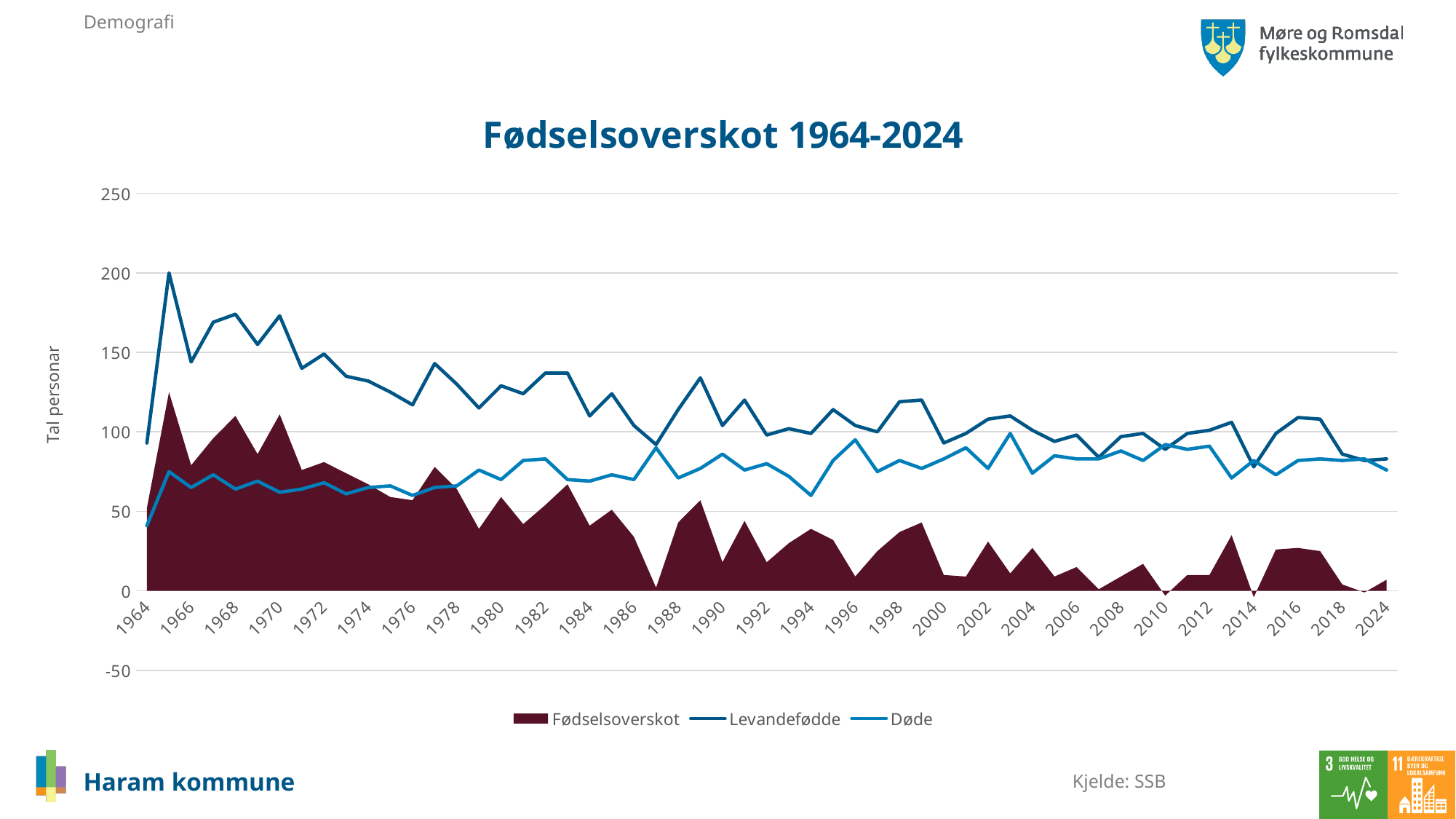
Which is larger in 1965, Levandefødde or Døde? Levandefødde Is the value for Døde in 1964 greater or less than 50? less What is the title of the chart? Fødselsoverskot 1964-2024 Is the value for Fødselsoverskot in 1965 greater or less than 100? greater How many series does the legend list? 3 Which series is drawn as a filled dark red area? Fødselsoverskot Which is larger for Levandefødde, the value in 1965 or the value in 2024? 1965 In which year does the Levandefødde series reach its highest value? 1965 Is the value for Levandefødde in 2024 greater or less than 100? less What is the label of the vertical axis? Tal personar Does the Levandefødde series generally rise or fall from 1965 to 2024? fall